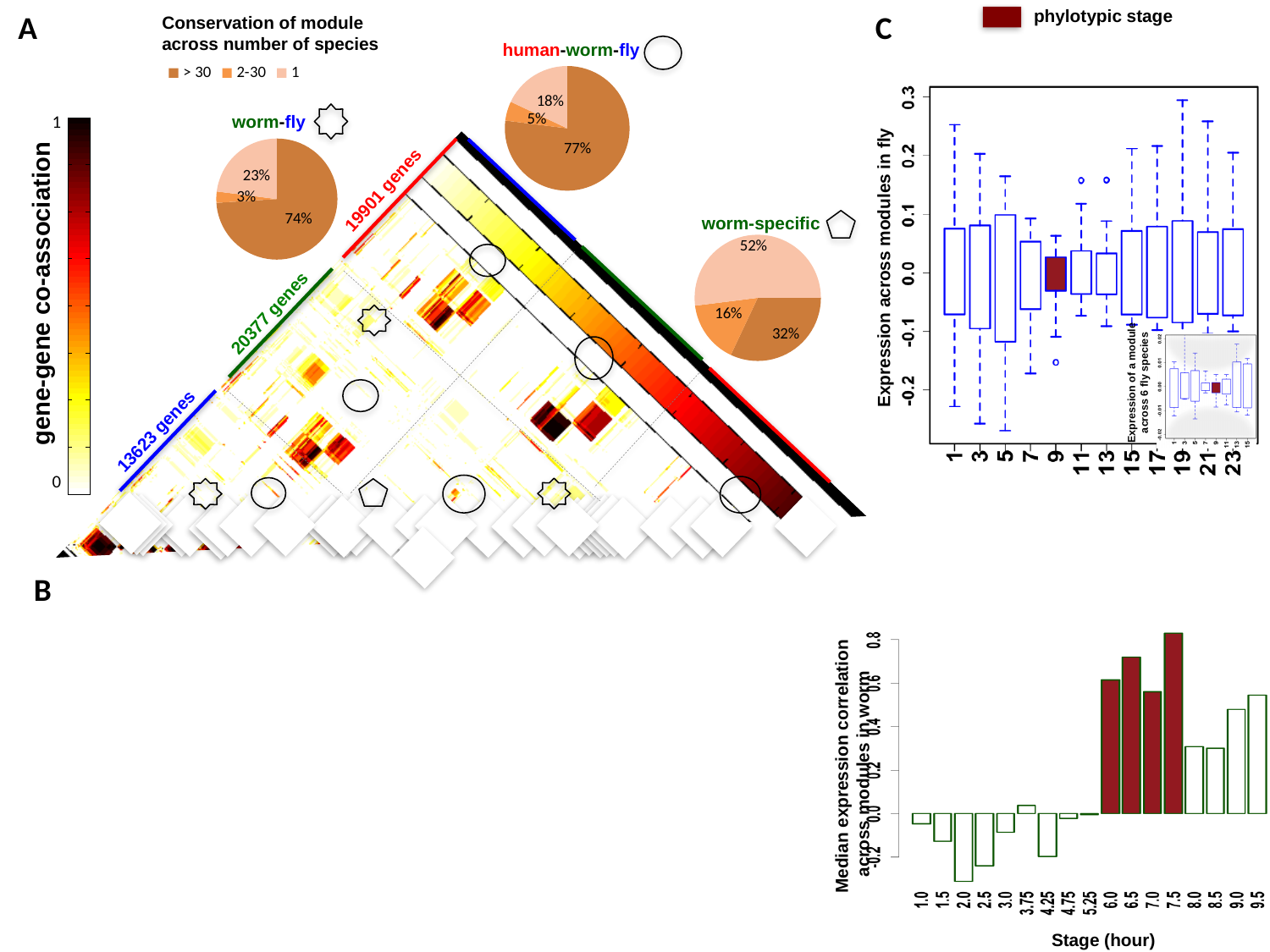
In the worm-fly pie chart, what share of modules is conserved across more than 30 species? 74% In panel B, at which stage (hour) is the median expression correlation across modules in worm lowest? 2.0 Which is larger: the > 30 species share in the worm-fly pie chart or in the human-worm-fly pie chart? human-worm-fly In panel B, at which stage (hour) is the median expression correlation across modules in worm highest? 7.5 In panel C, how many stages are shown on the x axis of the box plot? 12 In panel B, how many stages (hours) are shown on the x axis? 17 In the worm-specific pie chart, which conservation category has the largest slice? 1 In panel C, which stage is highlighted as the phylotypic stage? 9 In the worm-specific pie chart, what share of modules is conserved in only 1 species? 52% In panel B, is the value at stage 7.5 greater or less than 0.6? greater In the human-worm-fly pie chart, what is the difference between the share for > 30 species and the share for 1 species? 59% In the human-worm-fly pie chart, what share of modules is conserved across 2-30 species? 5%